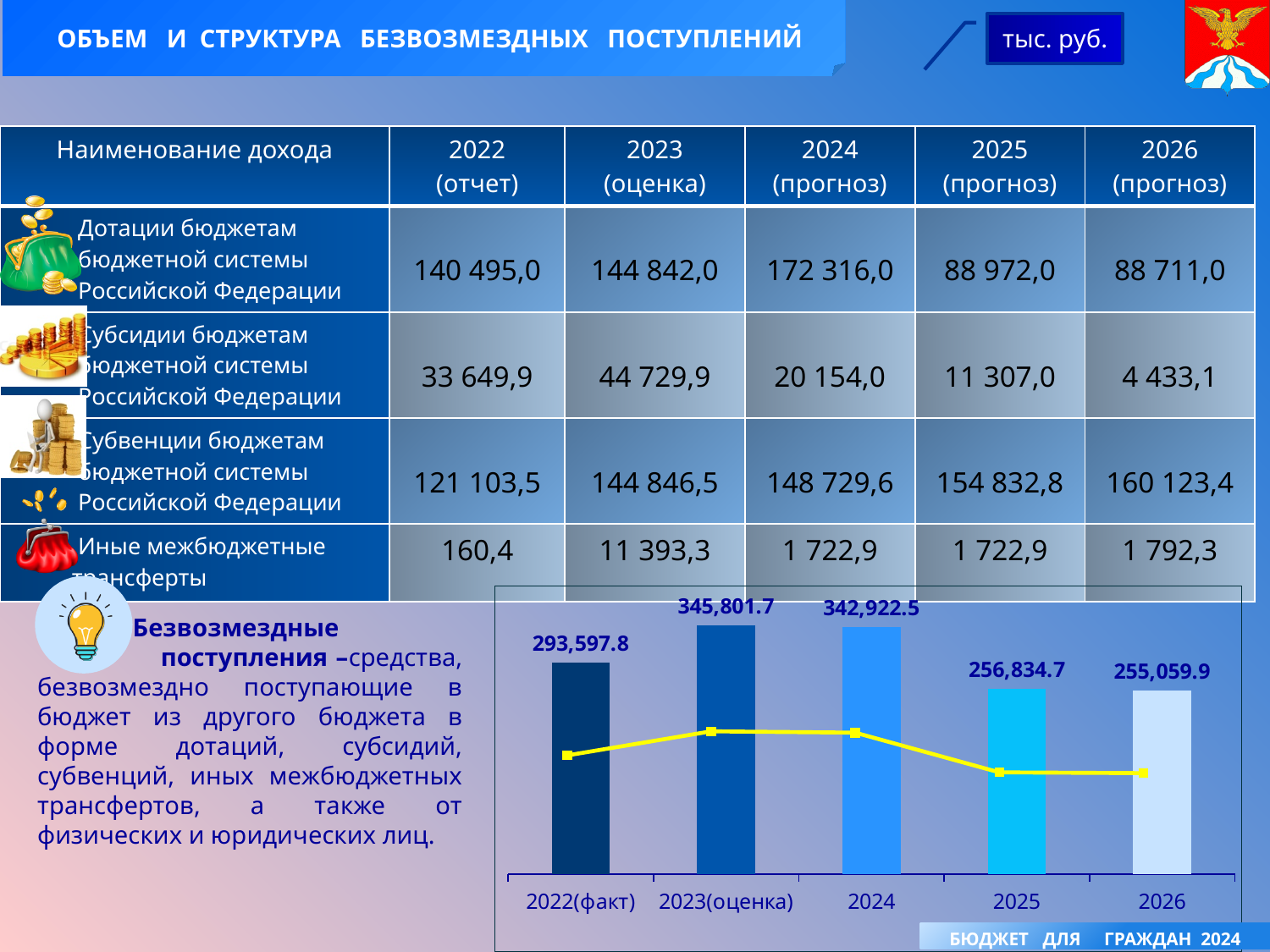
What is the difference between the values for 2024 and 2025? 86,087.8 What is the difference between the values for 2023(оценка) and 2022(факт)? 52,203.9 What is the value shown for 2022(факт) in the chart? 293,597.8 What is the value shown for 2025 in the chart? 256,834.7 Which category has the highest value in the chart? 2023(оценка) Which is larger, the value for 2022(факт) or the value for 2025? 2022(факт) Which category has the lowest value in the chart? 2026 What is the value shown for 2024 in the chart? 342,922.5 What is the value shown for 2023(оценка) in the chart? 345,801.7 What kind of chart is shown at the bottom of the slide? Bar chart with a line overlay What is the value shown for 2026 in the chart? 255,059.9 How many categories are shown on the x axis of the chart? 5